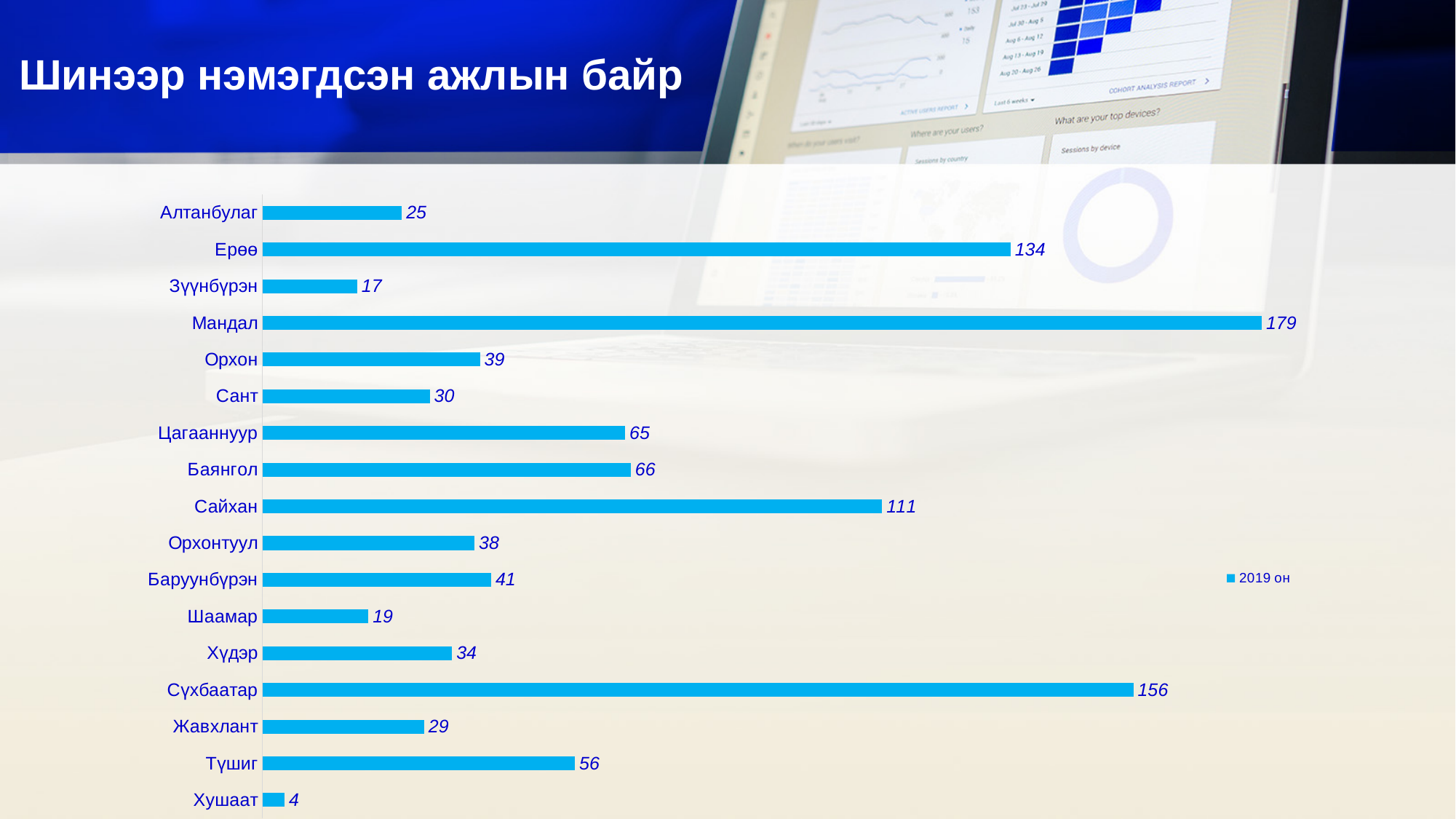
What kind of chart is shown on the slide? Bar chart Which category has the lowest value? Хушаат What is the legend entry of the chart? 2019 он How many categories are shown in the chart? 17 How many series does the legend list? 1 What is the value for Мандал? 179 What is the value for Сайхан? 111 Which is larger, the value for Орхон or the value for Хүдэр? Орхон What is the difference between the values for Цагааннуур and Алтанбулаг? 40 What is the value for Түшиг? 56 Which category has the highest value? Мандал What is the difference between the values for Сүхбаатар and Ерөө? 22